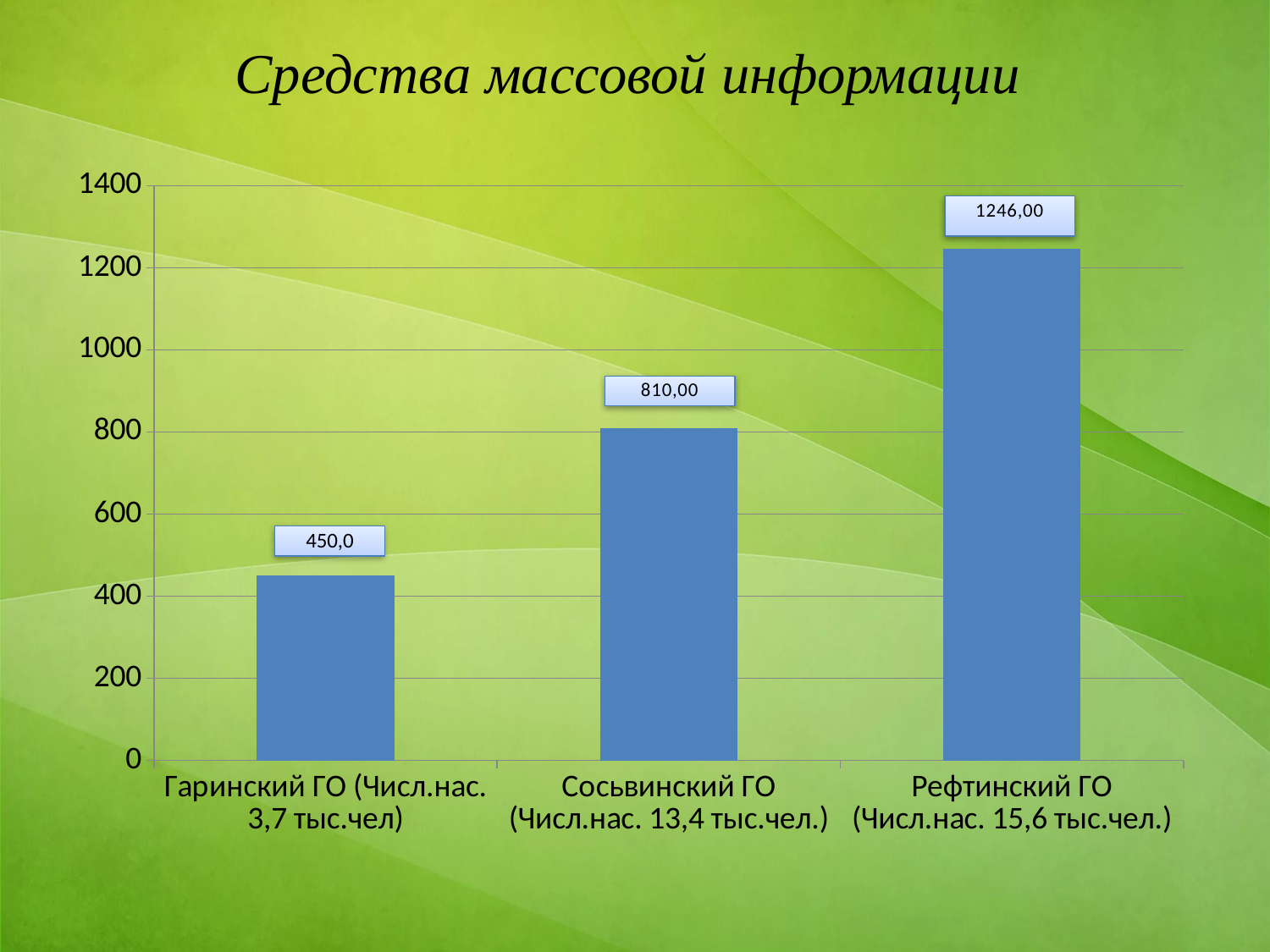
Which category has the highest value? Рефтинский ГО What kind of chart is shown on the slide? bar chart What is the value for Гаринский ГО? 450,0 Is the value for Рефтинский ГО greater or less than 1000? greater What is the value for Сосьвинский ГО? 810,00 What is the difference between the values for Сосьвинский ГО and Гаринский ГО? 360 What is the title of the chart? Средства массовой информации What is the value for Рефтинский ГО? 1246,00 What is the difference between the values for Рефтинский ГО and Сосьвинский ГО? 436 Which is larger, the value for Сосьвинский ГО or the value for Гаринский ГО? Сосьвинский ГО How many categories are shown on the chart? 3 Which category has the lowest value? Гаринский ГО